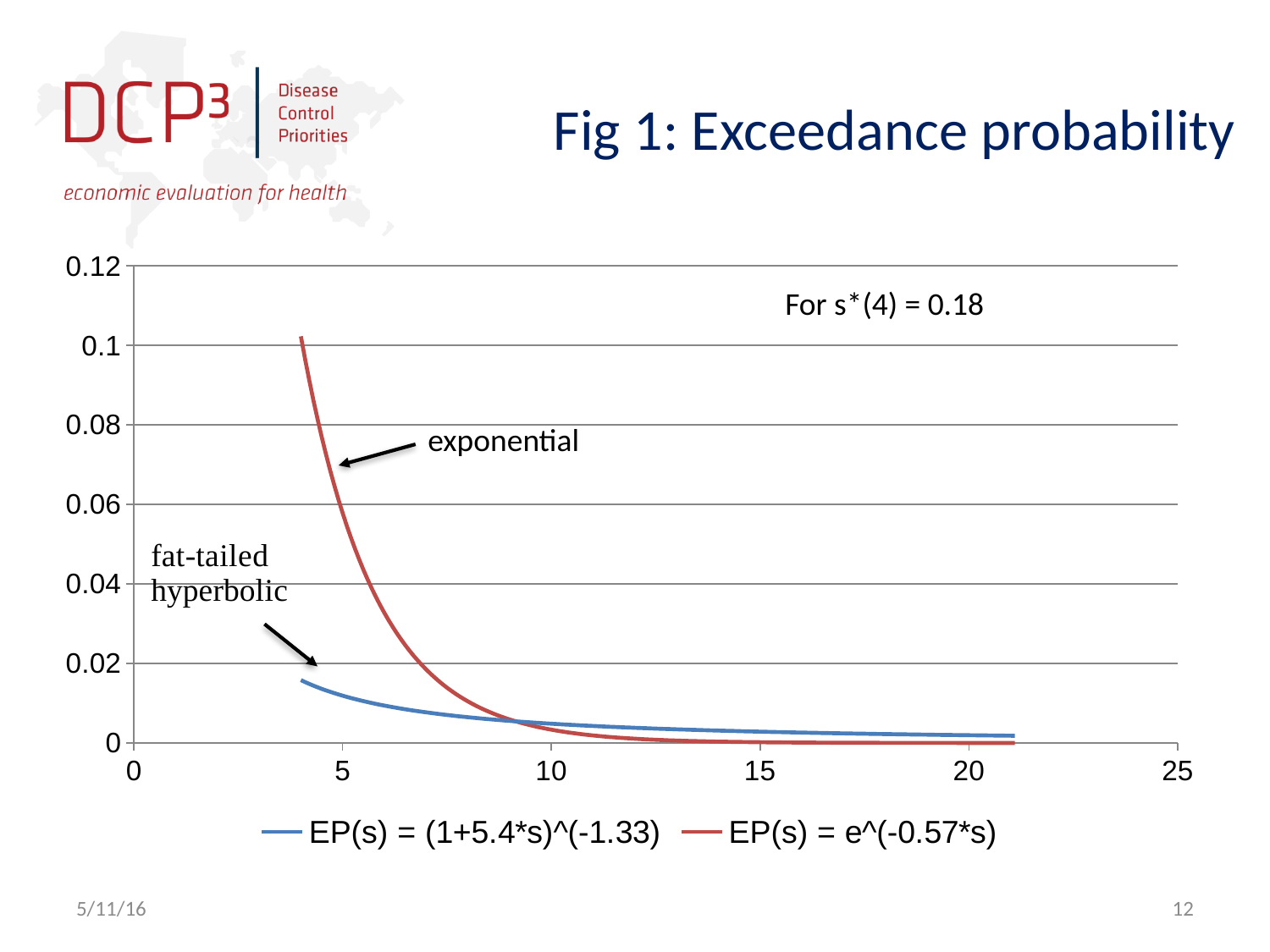
Is the value of the red line EP(s) = e^(-0.57*s) at s = 4 greater or less than 0.08? greater At s = 15, which series has the higher value, EP(s) = e^(-0.57*s) or EP(s) = (1+5.4*s)^(-1.33)? EP(s) = (1+5.4*s)^(-1.33) Is the value of the red line EP(s) = e^(-0.57*s) at s = 6 greater or less than 0.04? less Is the value of the blue line EP(s) = (1+5.4*s)^(-1.33) at s = 4 greater or less than 0.02? less At s = 5, which series has the higher value, EP(s) = e^(-0.57*s) or EP(s) = (1+5.4*s)^(-1.33)? EP(s) = e^(-0.57*s) How many series does the legend list? 2 What kind of chart is shown on the slide? line chart Do the values of the blue line EP(s) = (1+5.4*s)^(-1.33) rise or fall as s increases along the x axis? fall Which legend entry corresponds to the red line? EP(s) = e^(-0.57*s) What is the title of the chart on the slide? Fig 1: Exceedance probability Do the values of the red line EP(s) = e^(-0.57*s) rise or fall as s increases along the x axis? fall What is the highest value shown on the y axis of the chart? 0.12